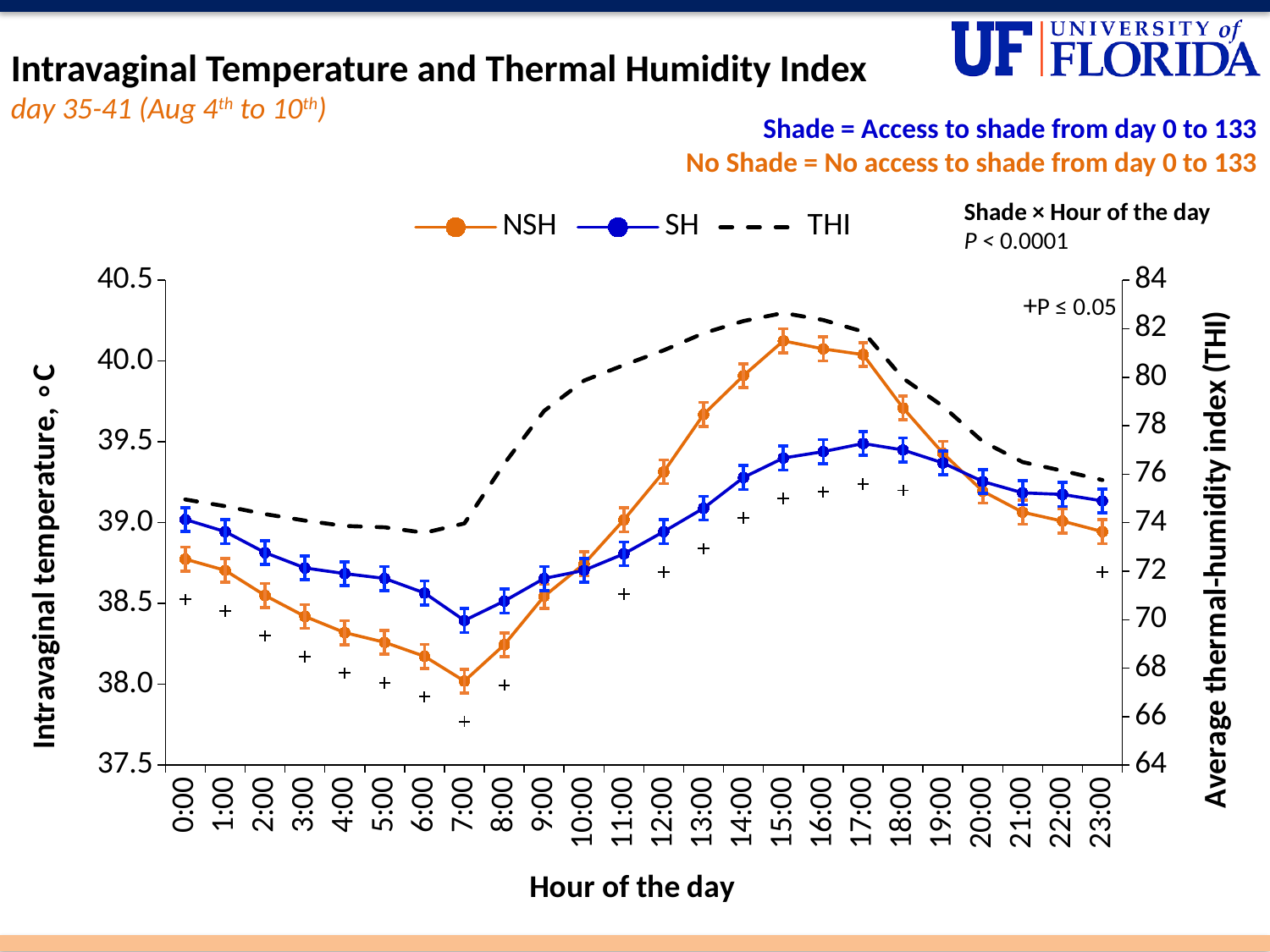
At which hour of the day does the SH series reach its lowest value? 7:00 Is the NSH value at 15:00 greater or less than 40.0? greater At 15:00, which series has the higher intravaginal temperature, NSH or SH? NSH Is the NSH value at 7:00 greater or less than 38.5? less What is the title of the right-hand y axis? Average thermal-humidity index (THI) At which hour of the day does the NSH series reach its lowest value? 7:00 What kind of chart is shown on the slide? line chart Is the THI value at 15:00 greater or less than 80? greater How many series does the legend list? 3 At which hour of the day does the NSH series reach its highest value? 15:00 How many hours of the day are plotted along the x axis? 24 Does the NSH series rise or fall between 7:00 and 15:00? rise